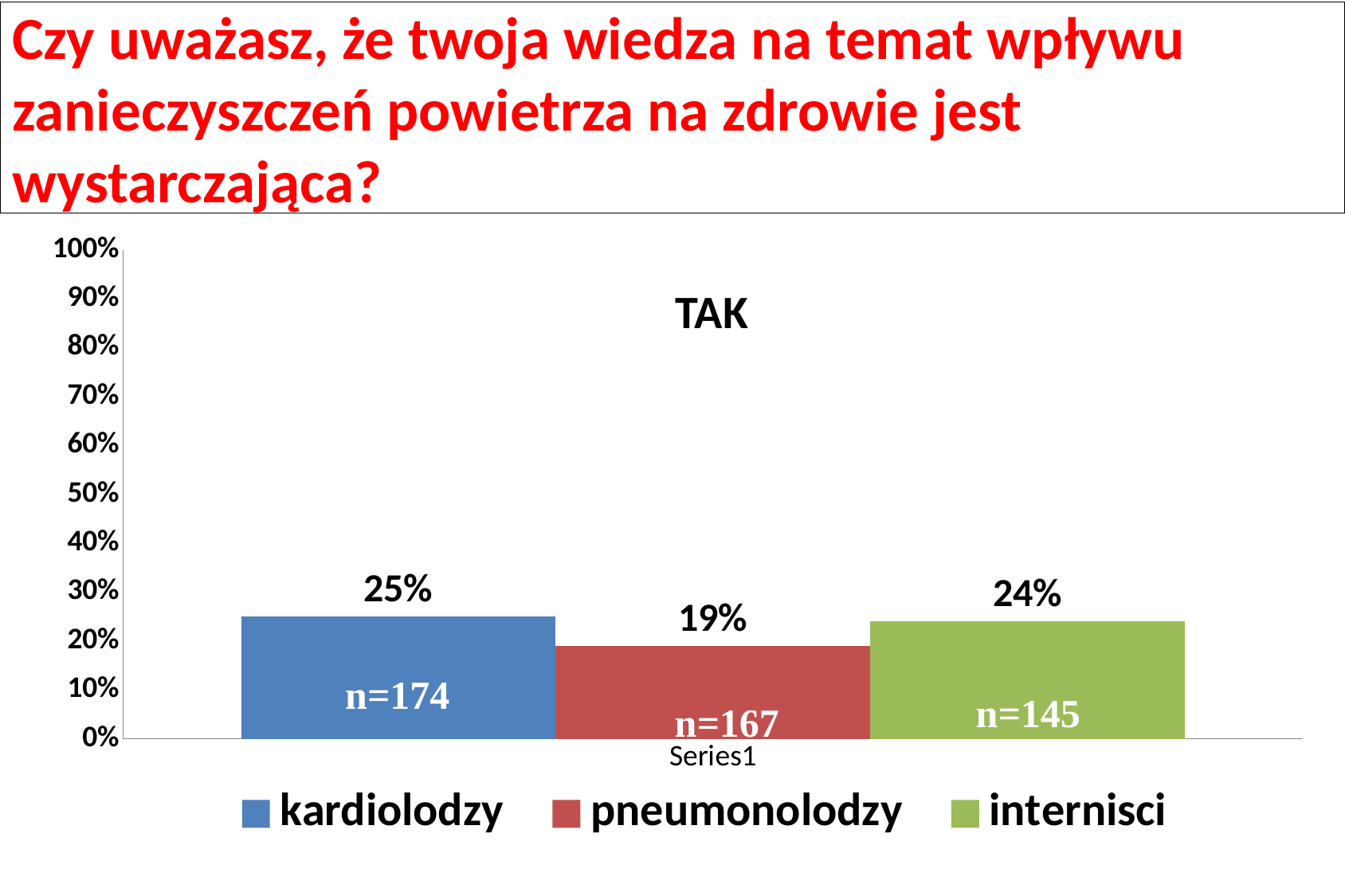
Which group has the lowest percentage? pneumonolodzy What kind of chart is shown on the slide? bar chart What percentage is shown for kardiolodzy? 25% What label is printed above the bars inside the chart area? TAK How many series does the legend list? 3 What sample size (n) is printed on the bar for internisci? n=145 Which is larger, the value for internisci or the value for pneumonolodzy? internisci What percentage is shown for pneumonolodzy? 19% Which group has the highest percentage? kardiolodzy Is the value for pneumonolodzy greater or less than 20%? less What percentage is shown for internisci? 24% What is the difference in percentage points between kardiolodzy and pneumonolodzy? 6